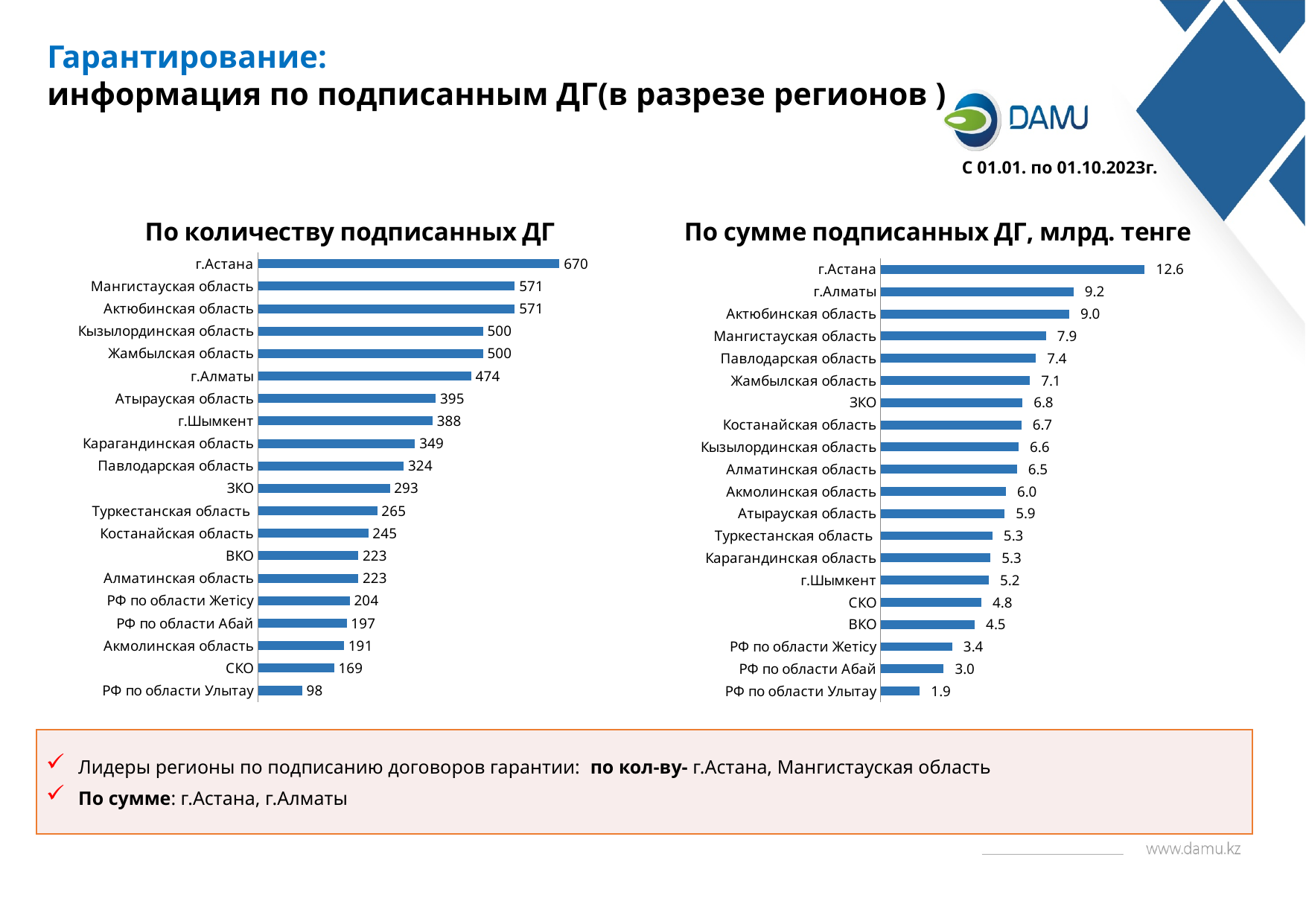
What is the title of the left chart on the slide? По количеству подписанных ДГ On the chart 'По сумме подписанных ДГ, млрд. тенге', which is larger: СКО or ВКО? СКО On the chart 'По количеству подписанных ДГ', which region has the highest value? г.Астана On the chart 'По количеству подписанных ДГ', which is larger: Атырауская область or г.Шымкент? Атырауская область How many regions are shown on the chart 'По сумме подписанных ДГ, млрд. тенге'? 20 How many regions are shown on the chart 'По количеству подписанных ДГ'? 20 What type of chart is 'По сумме подписанных ДГ, млрд. тенге'? Bar chart On the chart 'По сумме подписанных ДГ, млрд. тенге', which region has the lowest value? РФ по области Улытау On the chart 'По сумме подписанных ДГ, млрд. тенге', what is the value for Павлодарская область? 7.4 On the chart 'По сумме подписанных ДГ, млрд. тенге', what is the difference between г.Астана and г.Алматы? 3.4 On the chart 'По количеству подписанных ДГ', what is the value for г.Алматы? 474 On the chart 'По количеству подписанных ДГ', what is the difference between г.Астана and Мангистауская область? 99